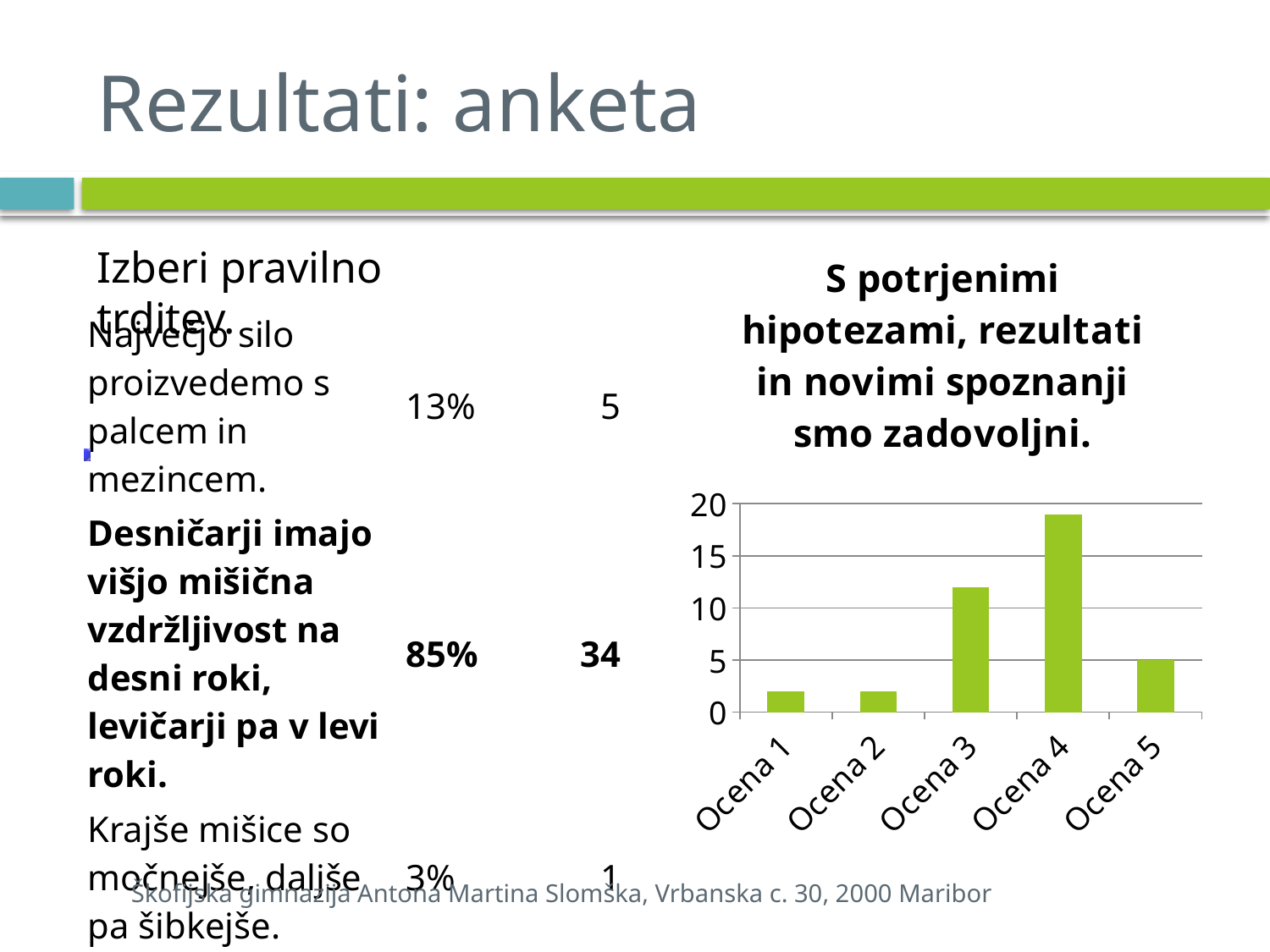
Is the value for Ocena 4 greater or less than 15? greater Is the value for Ocena 3 greater or less than 15? less Which is larger, the value for Ocena 5 or the value for Ocena 3? Ocena 3 How many categories are shown on the x axis of the chart? 5 What kind of chart is shown on the slide? bar chart What is the title of the chart? S potrjenimi hipotezami, rezultati in novimi spoznanji smo zadovoljni. Which category has the highest bar in the chart? Ocena 4 Which is larger, the value for Ocena 3 or the value for Ocena 4? Ocena 4 What is the value for Ocena 5 in the chart? 5 Is the value for Ocena 1 greater or less than 5? less